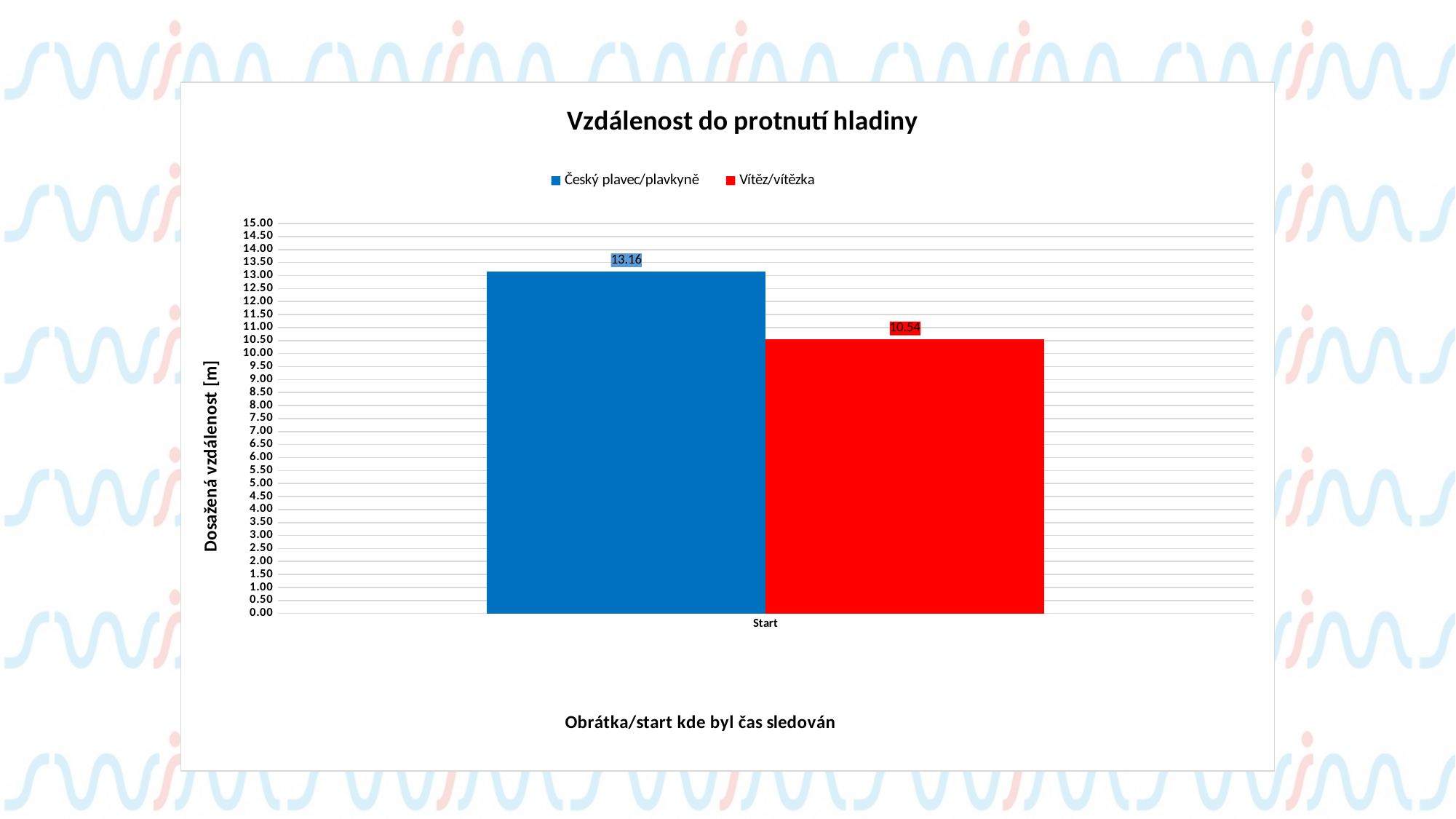
Is the value for Vítěz/vítězka greater or less than 11.00? less Which series has the lower value at Start? Vítěz/vítězka What is the title of the chart? Vzdálenost do protnutí hladiny Is the value for Český plavec/plavkyně greater or less than 12.00? greater How many categories are shown on the x axis? 1 How many series does the legend list? 2 What is the difference between the Český plavec/plavkyně value and the Vítěz/vítězka value at Start? 2.62 Which series has the higher value at Start? Český plavec/plavkyně What is the value for Český plavec/plavkyně at Start? 13.16 What kind of chart is shown? bar chart What colour is the bar for Vítěz/vítězka? red What is the value for Vítěz/vítězka at Start? 10.54